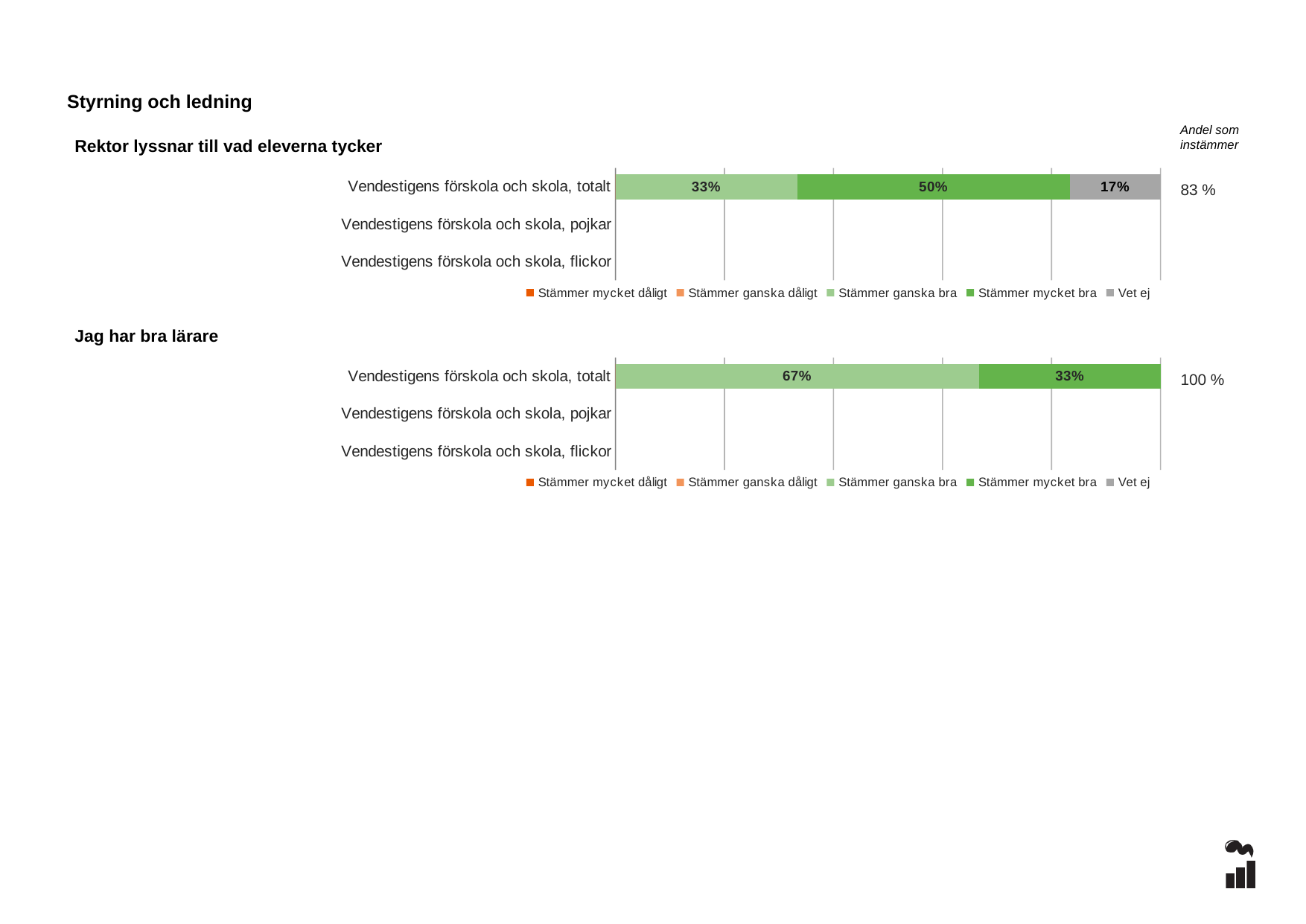
In the chart 'Rektor lyssnar till vad eleverna tycker', what is the value for 'Vet ej' for 'Vendestigens förskola och skola, totalt'? 17% In the chart 'Rektor lyssnar till vad eleverna tycker', what is the difference between the 'Stämmer mycket bra' and 'Stämmer ganska bra' values for 'Vendestigens förskola och skola, totalt'? 17% In the chart 'Jag har bra lärare', which is larger for 'Vendestigens förskola och skola, totalt': 'Stämmer ganska bra' or 'Stämmer mycket bra'? Stämmer ganska bra How many series does the legend of the chart 'Jag har bra lärare' list? 5 In the chart 'Rektor lyssnar till vad eleverna tycker', which segment is the largest for 'Vendestigens förskola och skola, totalt'? Stämmer mycket bra In the chart 'Jag har bra lärare', what is the value for 'Stämmer ganska bra' for 'Vendestigens förskola och skola, totalt'? 67% In the chart 'Jag har bra lärare', what is the value for 'Stämmer mycket bra' for 'Vendestigens förskola och skola, totalt'? 33% What kind of chart is 'Rektor lyssnar till vad eleverna tycker'? Stacked bar chart In the chart 'Jag har bra lärare', what is the difference between the 'Stämmer ganska bra' and 'Stämmer mycket bra' values for 'Vendestigens förskola och skola, totalt'? 34% In the chart 'Rektor lyssnar till vad eleverna tycker', what is the value for 'Stämmer ganska bra' for 'Vendestigens förskola och skola, totalt'? 33% In the chart 'Rektor lyssnar till vad eleverna tycker', what is the value for 'Stämmer mycket bra' for 'Vendestigens förskola och skola, totalt'? 50% What is the 'Andel som instämmer' value shown next to the chart 'Jag har bra lärare'? 100 %